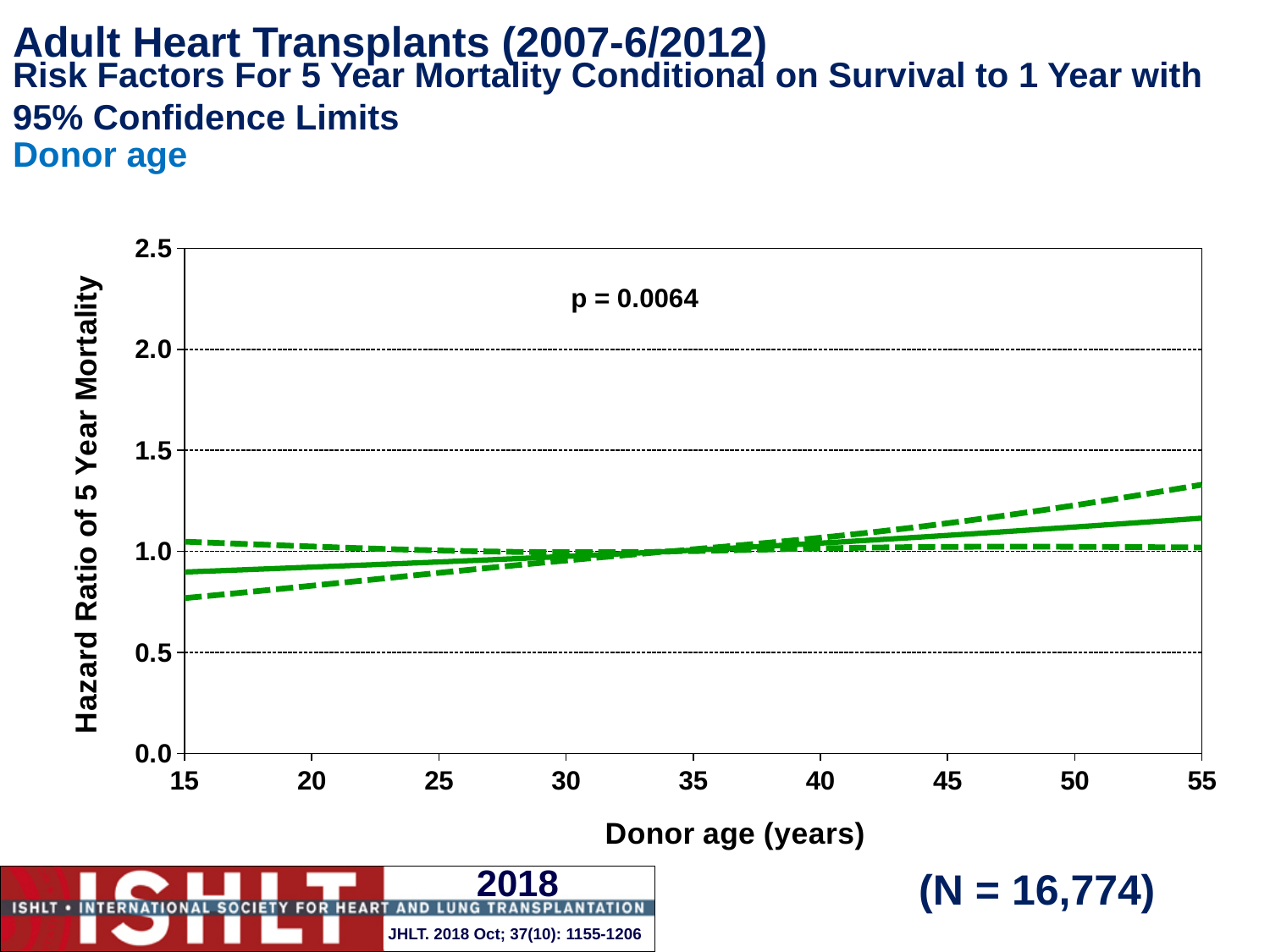
Does the hazard ratio of 5 year mortality (solid line) rise or fall as donor age increases from 15 to 55 years? rise At a donor age of 15 years, is the lower dashed confidence limit greater or less than 0.5? greater At a donor age of 15 years, is the hazard ratio on the solid line greater or less than 1.0? less How many lines are plotted on the chart? 3 Is the hazard ratio on the solid line larger at a donor age of 55 years or at 15 years? 55 years At a donor age of 55 years, is the upper dashed confidence limit greater or less than 1.5? less What p-value is printed on the chart? p = 0.0064 What kind of chart is shown on the slide? line chart What sample size (N) is shown on the slide? N = 16,774